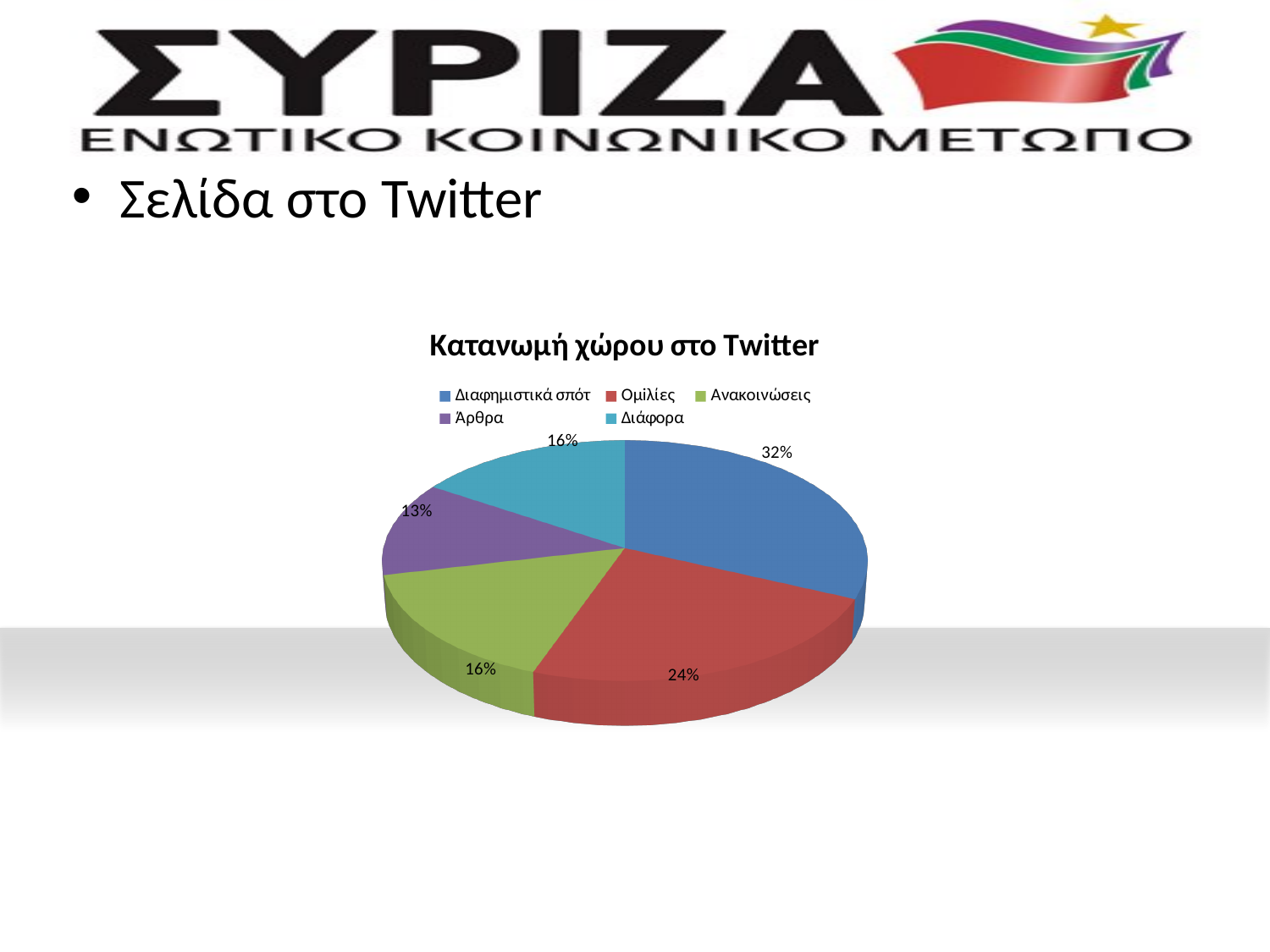
What share of the pie does Διαφημιστικά σπότ have? 32% Which is larger, the share for Ομιλίες or the share for Διάφορα? Ομιλίες What is the title of the chart? Κατανωμή χώρου στο Twitter Which category has the largest share of the pie? Διαφημιστικά σπότ Which category has the smallest share of the pie? Άρθρα Which colour represents Διάφορα in the pie chart? Cyan (light blue) What share of the pie does Άρθρα have? 13% What type of chart is shown on the slide? Pie chart How many categories does the pie chart have? 5 What is the difference in percentage points between Διαφημιστικά σπότ and Ομιλίες? 8 What share of the pie does Ανακοινώσεις have? 16%